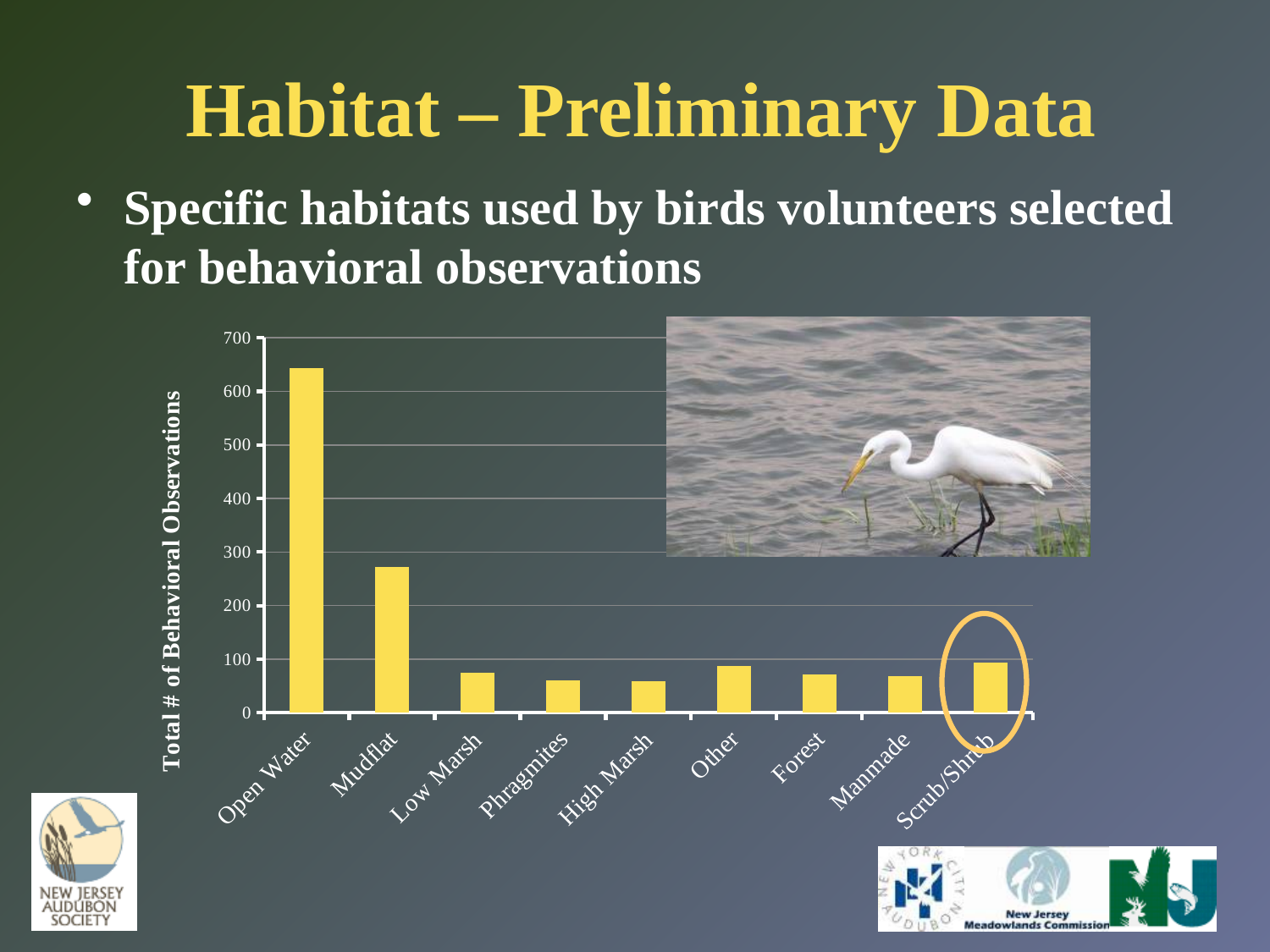
Is the value for Low Marsh greater or less than 100? less Which habitat has the highest total number of behavioral observations? Open Water Which has more behavioral observations, Mudflat or Other? Mudflat Is the value for Mudflat greater or less than 200? greater Which habitat category's bar is circled on the chart? Scrub/Shrub What is the label on the vertical axis of the chart? Total # of Behavioral Observations What kind of chart is shown on the slide? bar chart Which has more behavioral observations, Open Water or Mudflat? Open Water Is the value for Open Water greater or less than 600? greater How many habitat categories are shown on the x axis of the chart? 9